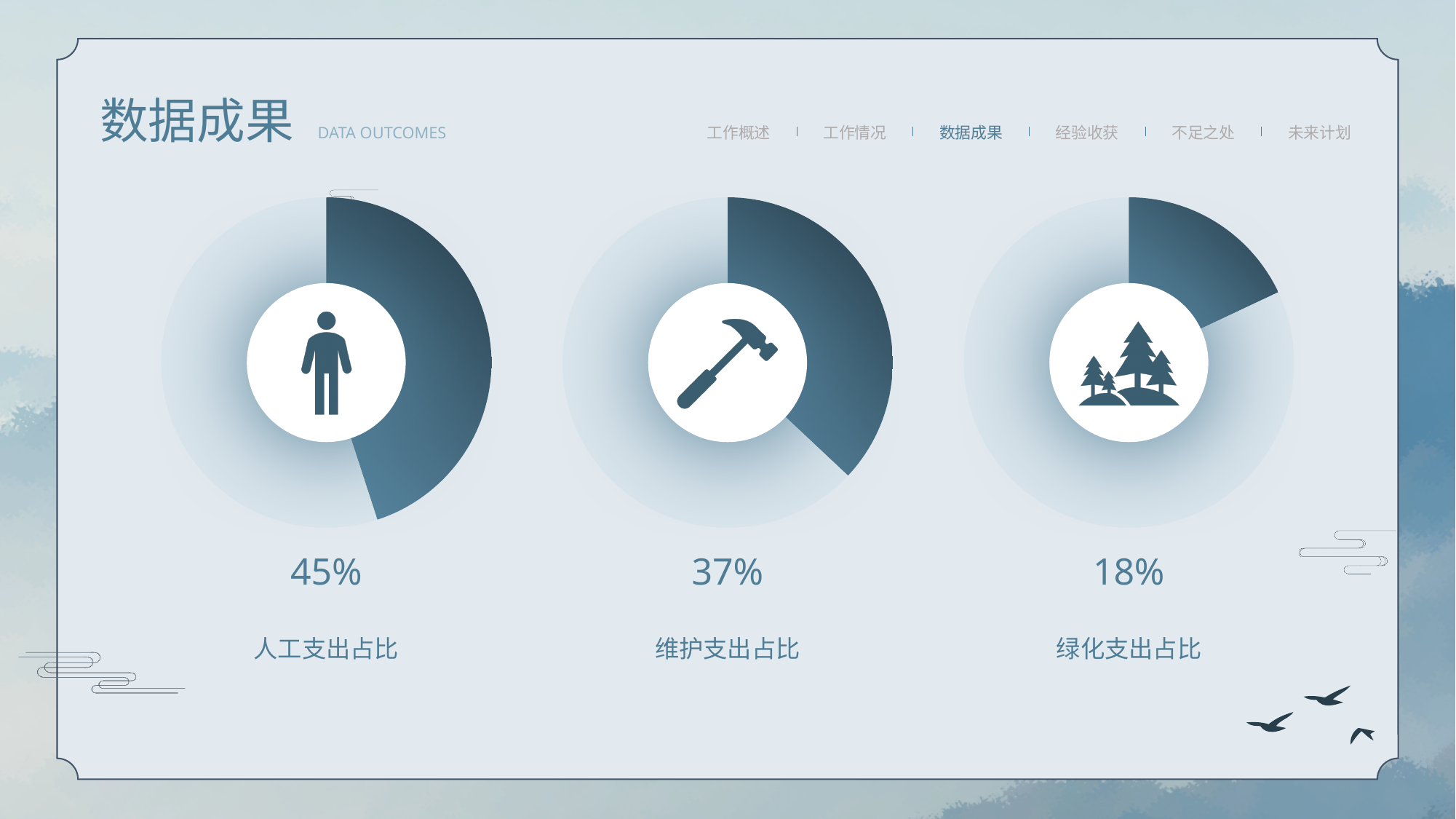
What is the title of the slide containing the three charts? 数据成果 What is the English subtitle shown next to the slide title? DATA OUTCOMES What is the difference between the 维护支出占比 value and the 绿化支出占比 value? 19% What is the difference between the 人工支出占比 value and the 维护支出占比 value? 8% Which is larger, the share for 人工支出占比 or the share for 绿化支出占比? 人工支出占比 What kind of chart is used to show each expense share on the slide? pie chart Which of the three expense categories has the lowest share? 绿化支出占比 Which of the three expense categories has the highest share? 人工支出占比 How many pie charts are shown on the slide? 3 What percentage is shown for 人工支出占比 (the left chart)? 45% What percentage is shown for 绿化支出占比 (the right chart)? 18% What percentage is shown for 维护支出占比 (the middle chart)? 37%